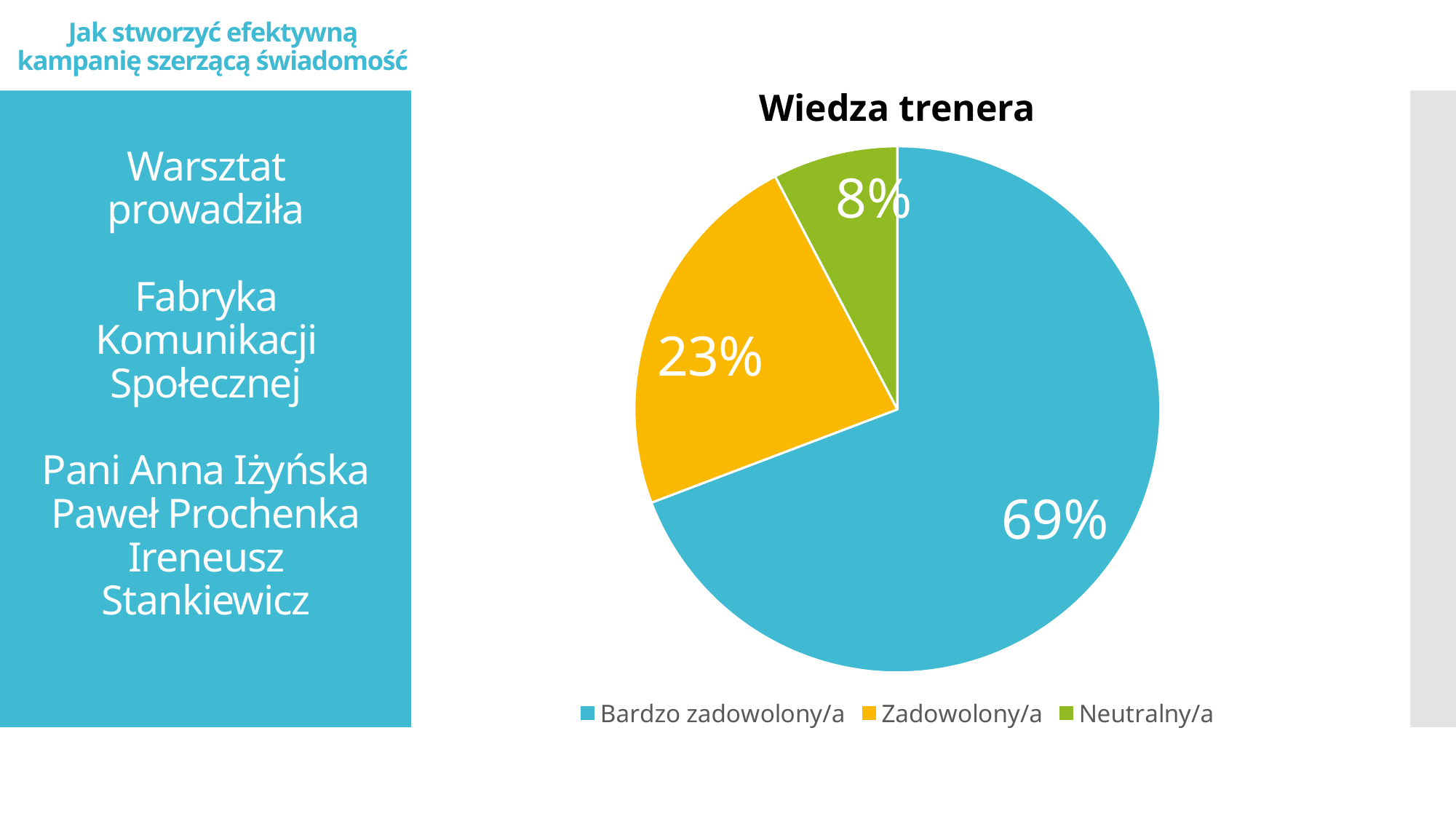
What share of the pie is labelled "Zadowolony/a"? 23% Which category has the smallest slice of the pie? Neutralny/a What is the difference between the shares for "Zadowolony/a" and "Neutralny/a"? 15% Which category has the largest slice of the pie? Bardzo zadowolony/a What share of the pie is labelled "Neutralny/a"? 8% What colour is the slice for "Neutralny/a"? green What is the difference between the shares for "Bardzo zadowolony/a" and "Zadowolony/a"? 46% What kind of chart is shown on the slide? pie chart What is the title of the chart? Wiedza trenera What share of the pie is labelled "Bardzo zadowolony/a"? 69% How many categories does the legend list? 3 Which is larger, the share for "Zadowolony/a" or the share for "Neutralny/a"? Zadowolony/a